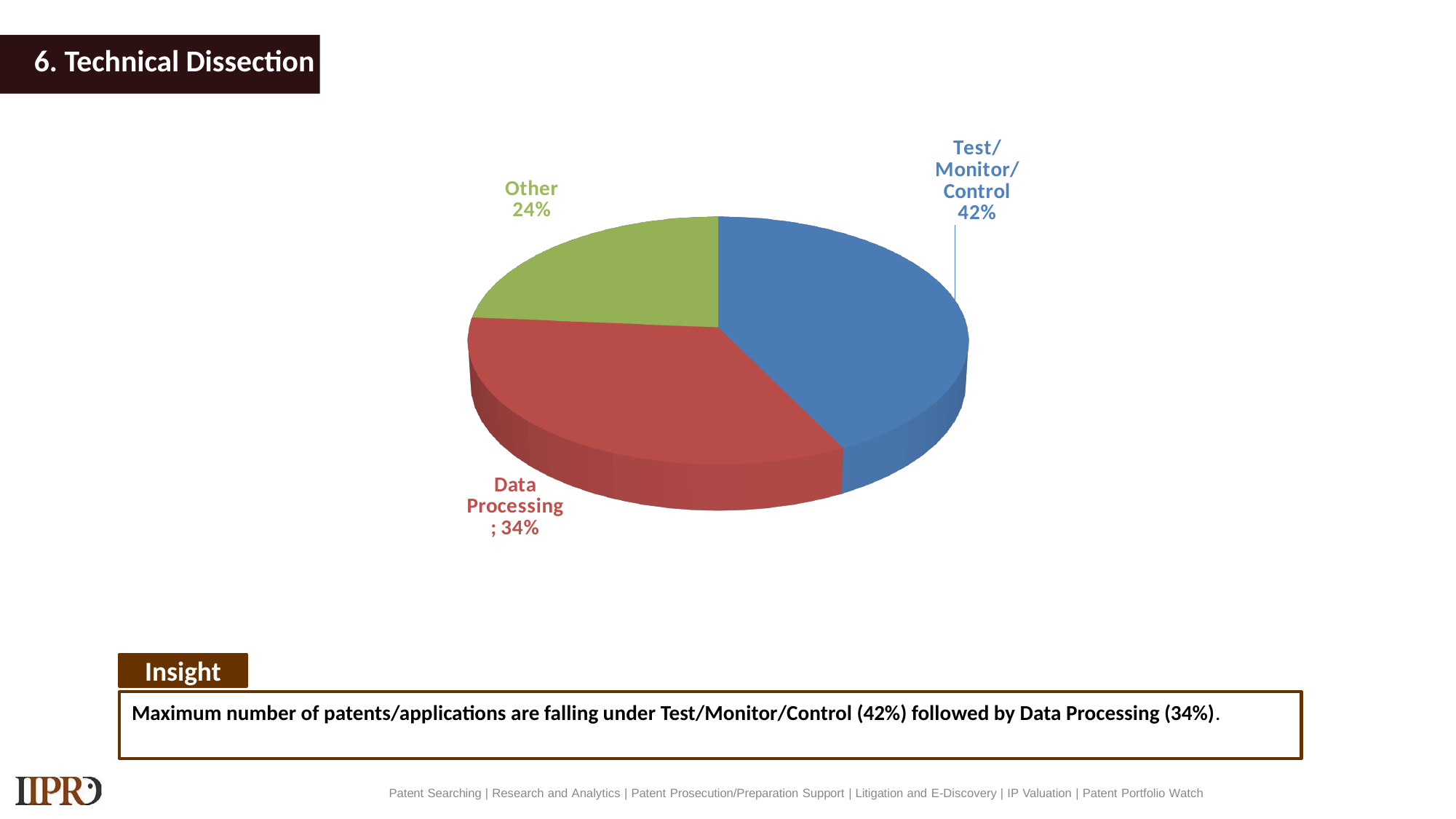
What colour is the Data Processing slice? Red What share of the pie does Data Processing account for? 34% What kind of chart is shown on the slide? Pie chart What is the difference in percentage points between Test/Monitor/Control and Data Processing? 8 What share of the pie does Other account for? 24% What colour is the Test/Monitor/Control slice? Blue Which is larger, the Data Processing slice or the Other slice? Data Processing Which category has the smallest slice of the pie? Other Which category has the largest slice of the pie? Test/Monitor/Control What share of the pie does Test/Monitor/Control account for? 42% What is the difference in percentage points between Data Processing and Other? 10 How many slices does the pie chart have? 3